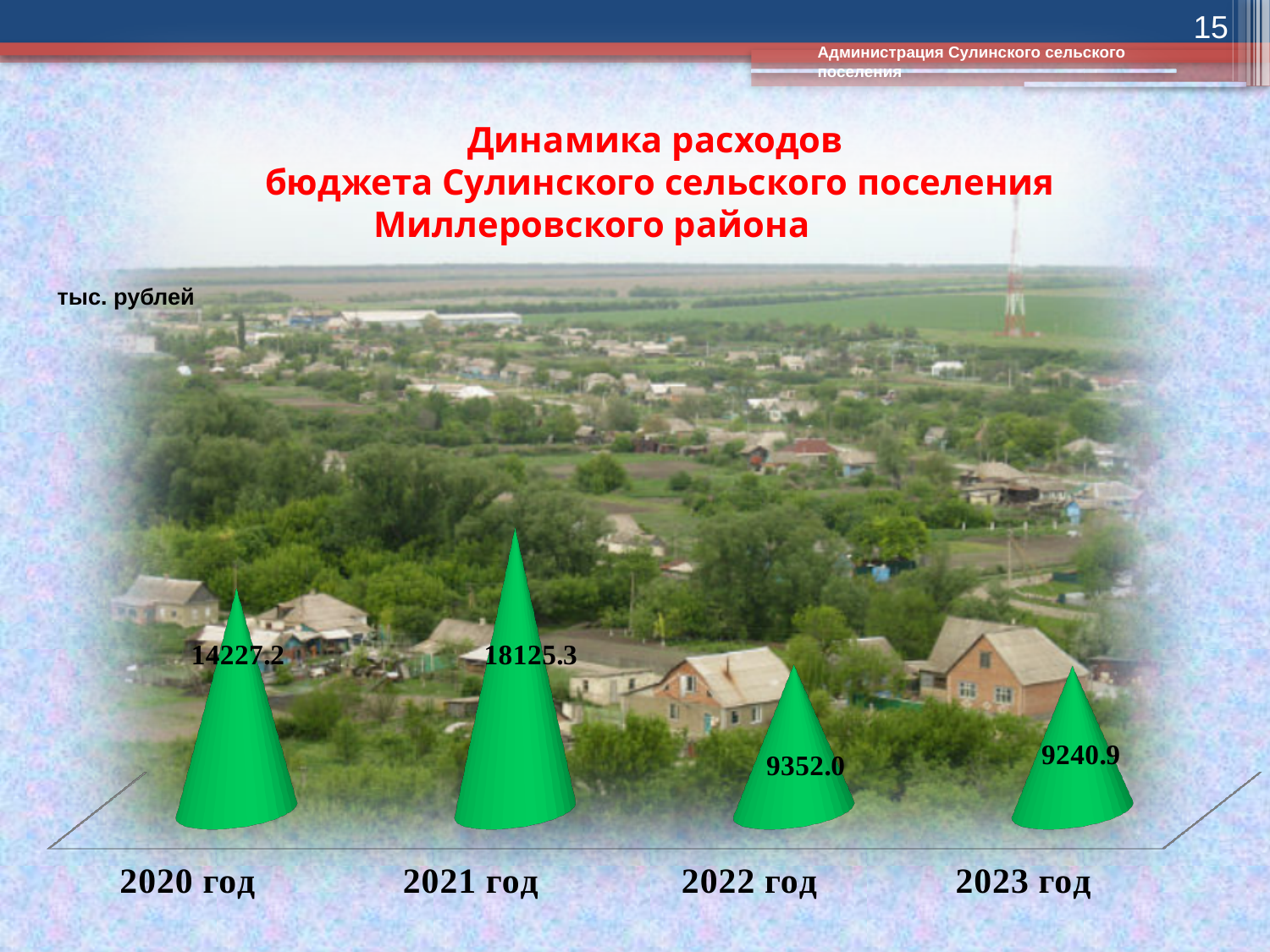
What kind of chart is this? Bar chart How many years are shown on the chart? 4 Which year has the highest value? 2021 год What is the value for 2020 год? 14227.2 What is the difference between the values for 2022 год and 2023 год? 111.1 What is the value for 2021 год? 18125.3 What unit is stated for the values on the chart? тыс. рублей What is the value for 2023 год? 9240.9 Which year has the lowest value? 2023 год Which is larger, the value for 2020 год or the value for 2022 год? 2020 год What is the value for 2022 год? 9352.0 What is the difference between the values for 2021 год and 2020 год? 3898.1